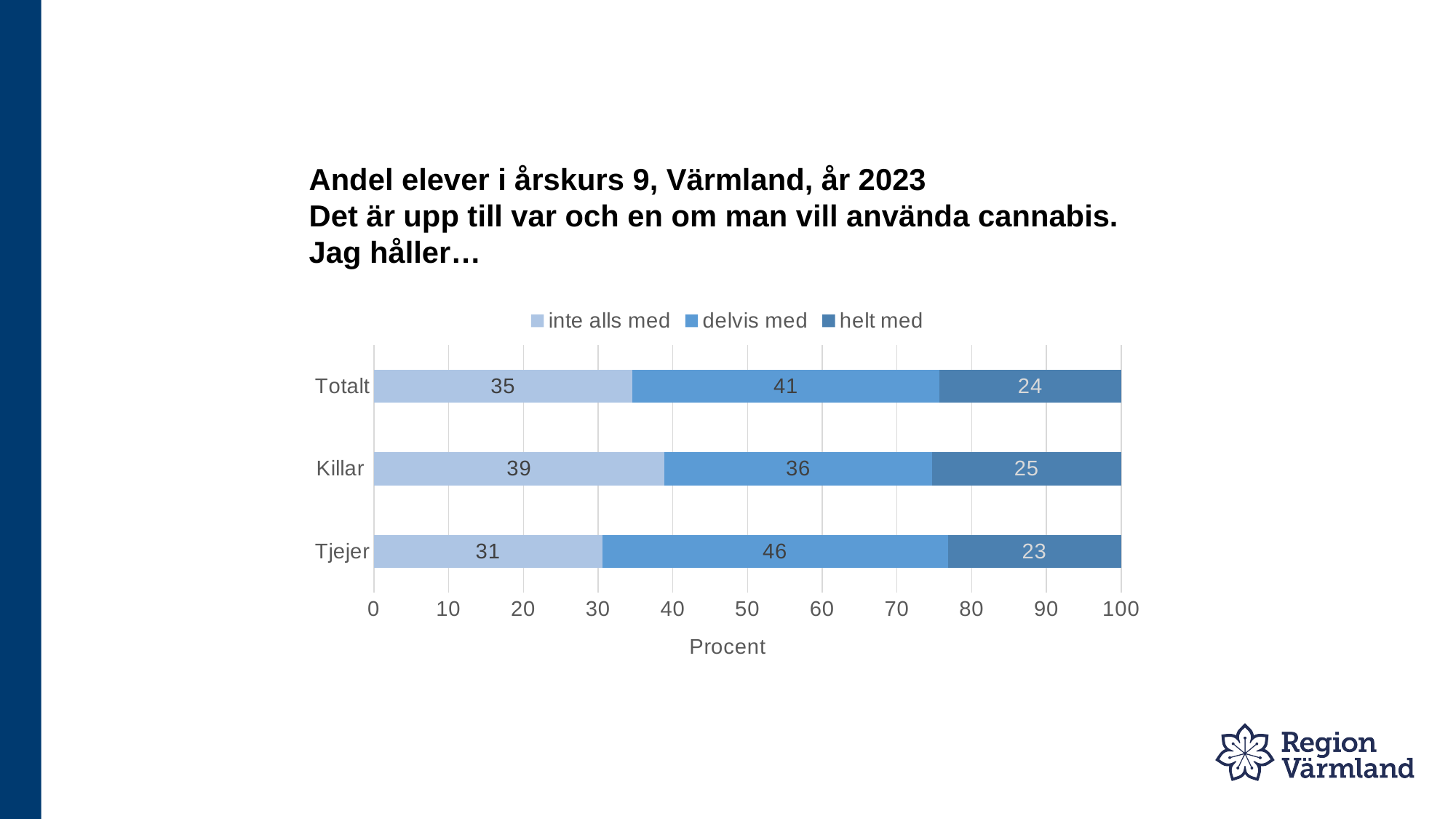
How many categories are shown on the y axis? 3 How many series does the legend list? 3 What is the value for "delvis med" for Tjejer? 46 What is the label of the x axis? Procent Which category has the lowest value for "delvis med"? Killar Which is larger: "inte alls med" for Tjejer or "inte alls med" for Totalt? Totalt What is the total of the stacked bar for Killar? 100 Which category has the highest value for "inte alls med"? Killar What is the value for "helt med" for Killar? 25 What kind of chart is shown? stacked bar chart What is the difference between the "delvis med" values for Tjejer and Killar? 10 What is the value for "inte alls med" for Totalt? 35